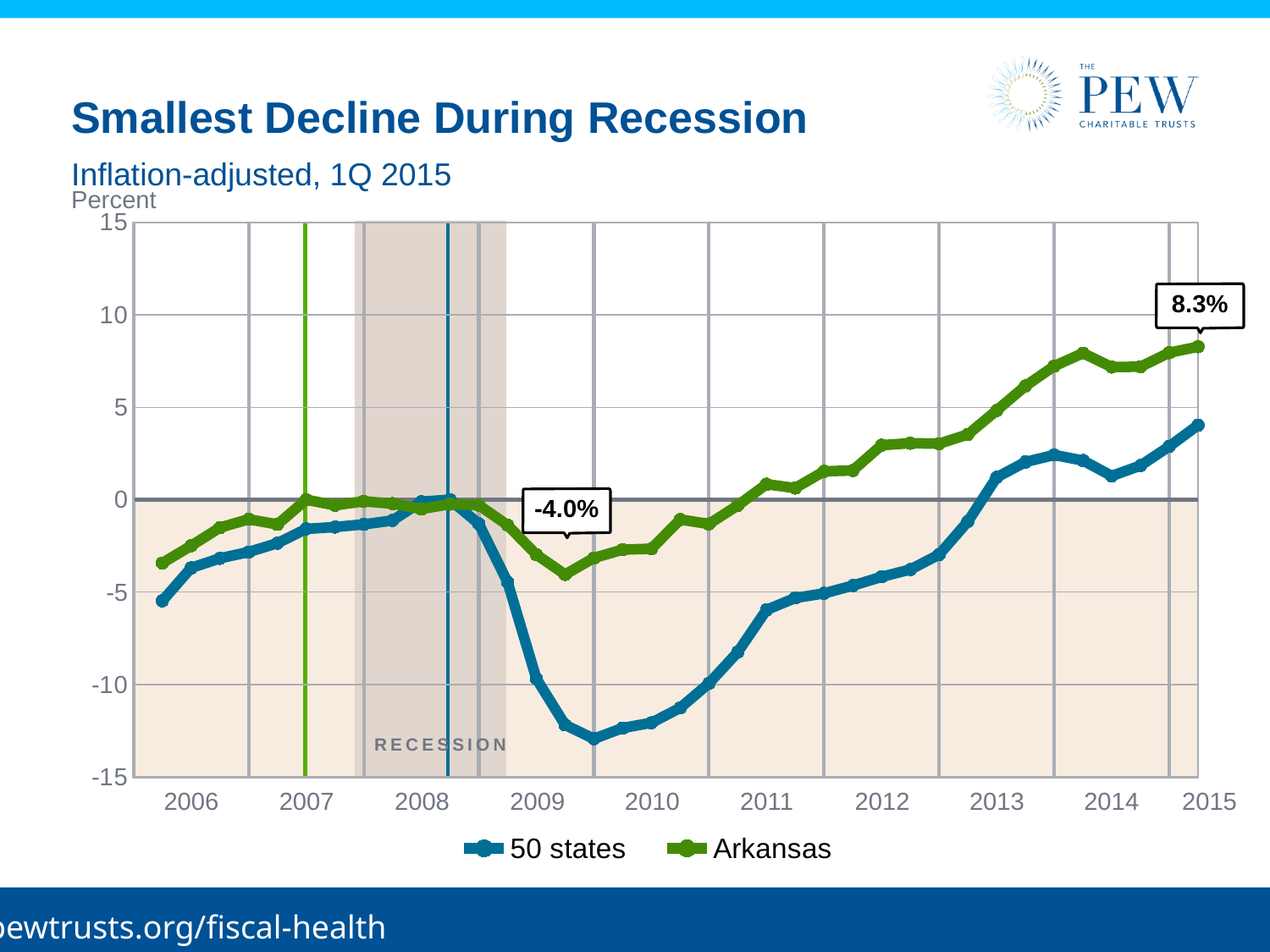
How many series does the legend list? 2 From 2009 to 2015, does the 50 states line rise or fall? Rise What are the two series named in the legend? 50 states and Arkansas At 2015, which series has the higher value, 50 states or Arkansas? Arkansas Which series reached the lower minimum value over the period shown? 50 states Is the lowest value of the 50 states line greater or less than -10? less What kind of chart is shown on the slide? Line chart What is the labeled value at the lowest point of the Arkansas line? -4.0% What is the title of the chart? Smallest Decline During Recession Is the value for 50 states at 2015 greater or less than 5? less What is the difference between Arkansas's labeled 2015 value and its labeled low point? 12.3 percentage points What is the labeled value for Arkansas at the end of the series in 2015? 8.3%